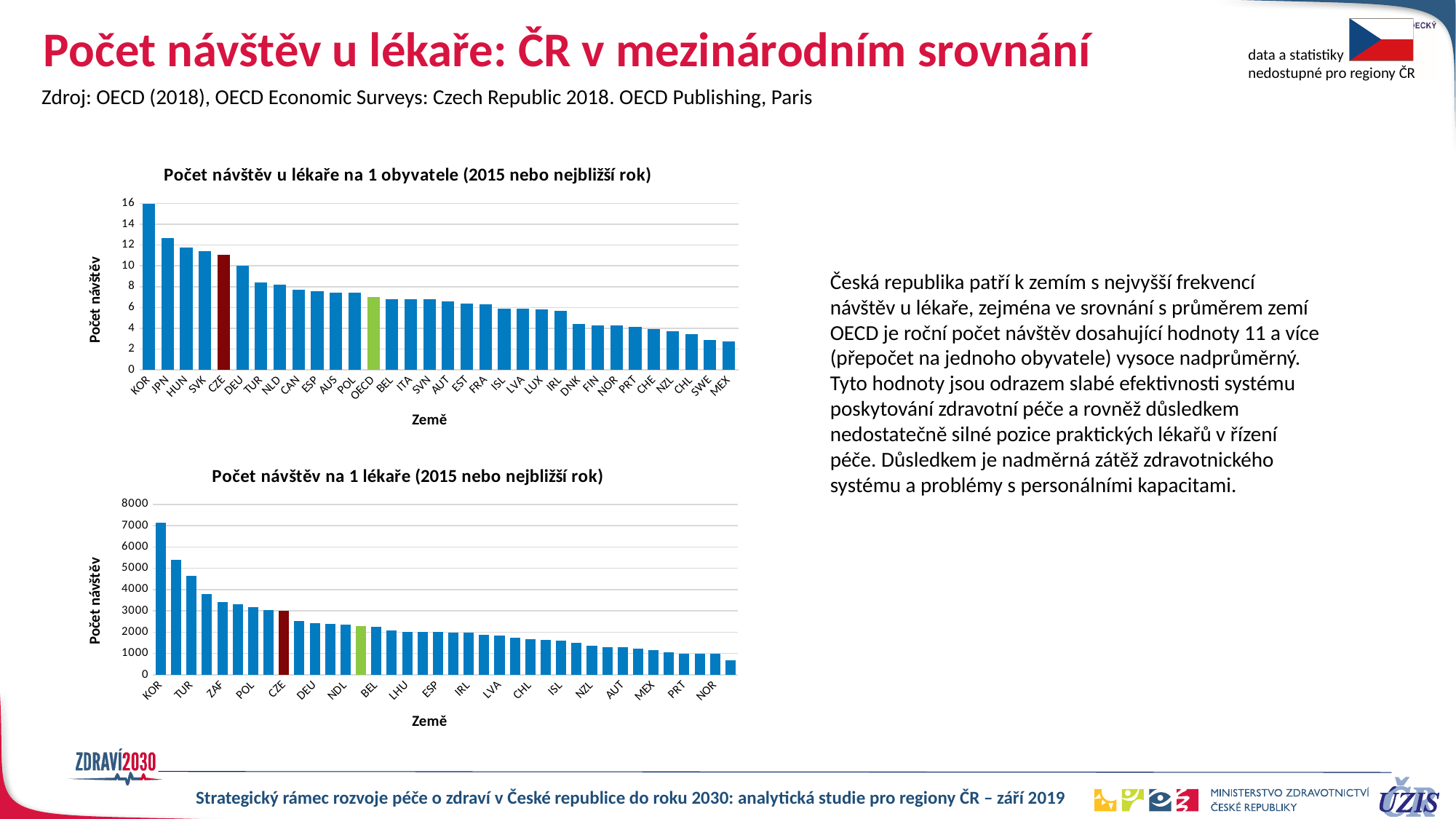
In the bottom chart, 'Počet návštěv na 1 lékaře (2015 nebo nejbližší rok)', which country has the highest value? KOR In the top chart (visits per inhabitant), which country has the lowest value? MEX In the top chart (visits per inhabitant), is the value for CZE greater or less than 10? greater In the top chart (visits per inhabitant), is the value for OECD greater or less than 8? less What kind of chart is the top chart, 'Počet návštěv u lékaře na 1 obyvatele (2015 nebo nejbližší rok)'? Bar chart In the bottom chart (visits per doctor), is the value for KOR greater or less than 6000? greater In the top chart (visits per inhabitant), which country has the highest value? KOR In the top chart (visits per inhabitant), what colour is the bar for CZE? Dark red How many countries/categories are shown in the top chart (visits per inhabitant)? 32 In the top chart (visits per inhabitant), which has a higher value, JPN or HUN? JPN In the top chart (visits per inhabitant), do the values rise or fall from left to right along the x axis? Fall